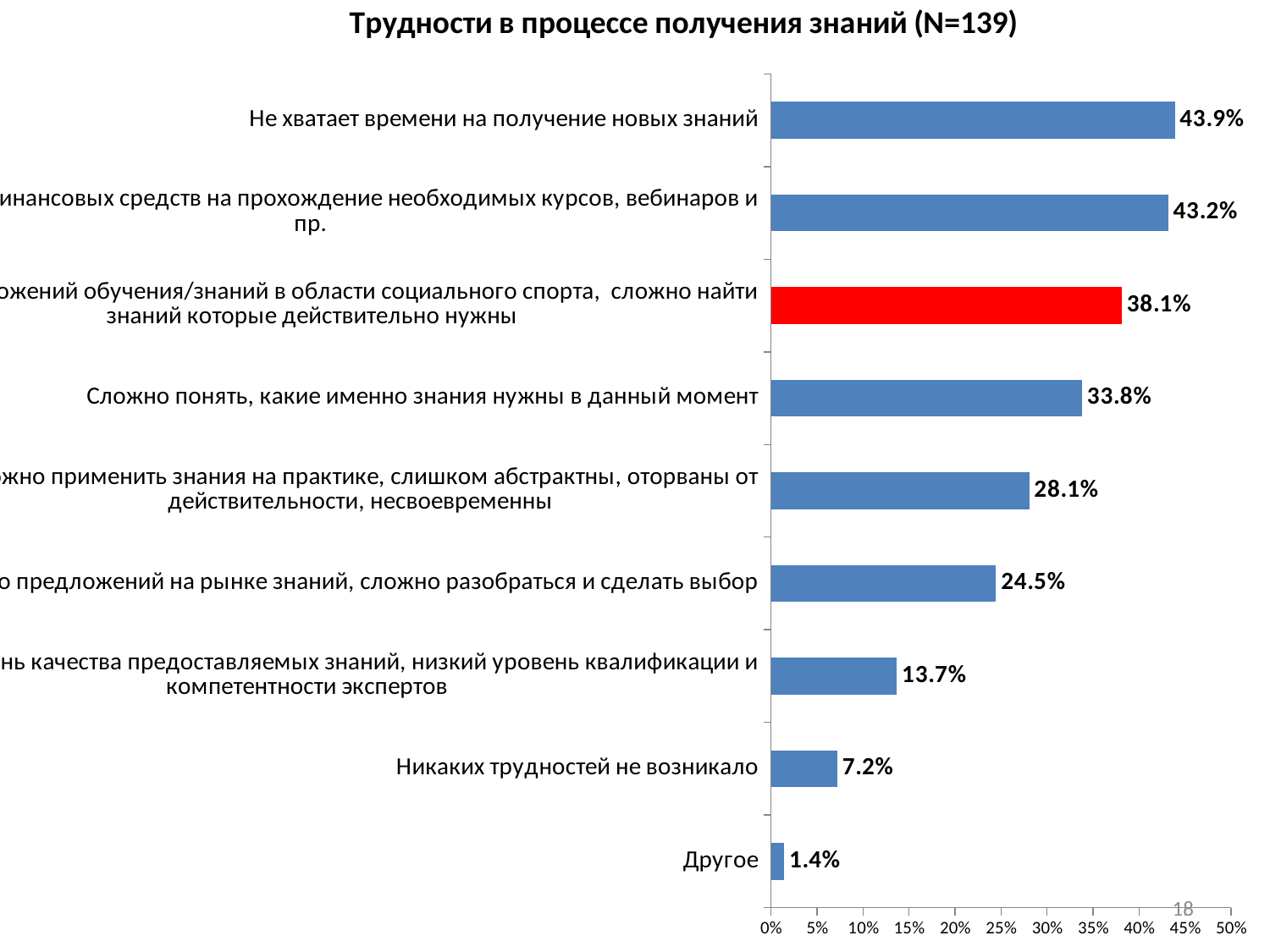
What is the sample size (N) stated in the chart title? 139 What is the value for "Не хватает времени на получение новых знаний"? 43.9% Which category has the highest value? Не хватает времени на получение новых знаний Which is larger: the value for "Никаких трудностей не возникало" or the value for "Другое"? Никаких трудностей не возникало What is the value shown on the red bar? 38.1% What is the value for "Сложно понять, какие именно знания нужны в данный момент"? 33.8% How many categories (bars) are shown in the chart? 9 What is the difference between the values for "Не хватает времени на получение новых знаний" and "Сложно понять, какие именно знания нужны в данный момент"? 10.1% What is the value for "Другое"? 1.4% What is the value for "Никаких трудностей не возникало"? 7.2% Which category has the lowest value? Другое What type of chart is shown on the slide? bar chart